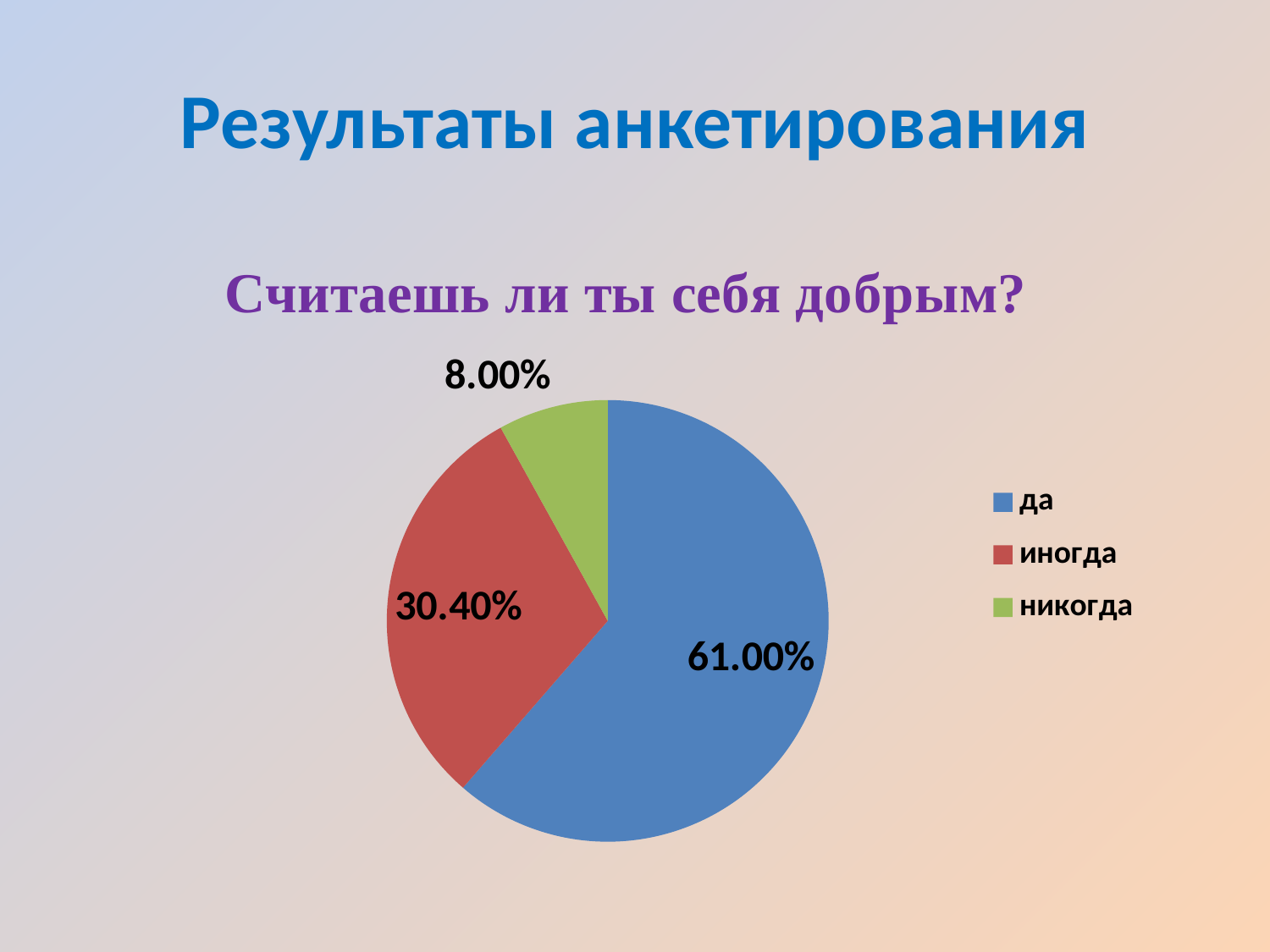
How many slices does the pie chart have? 3 What colour is the "никогда" slice in the pie chart? green Which category has the smallest slice of the pie? никогда Which is larger, the "иногда" slice or the "никогда" slice? иногда What is the difference in percentage points between the "да" and "иногда" slices? 30.60 What kind of chart is shown on the slide? pie chart What is the difference in percentage points between the "иногда" and "никогда" slices? 22.40 Which category has the largest slice of the pie? да What question is the pie chart titled with? Считаешь ли ты себя добрым? What share of the pie does the "никогда" slice represent? 8.00% What share of the pie does the "да" slice represent? 61.00% What share of the pie does the "иногда" slice represent? 30.40%